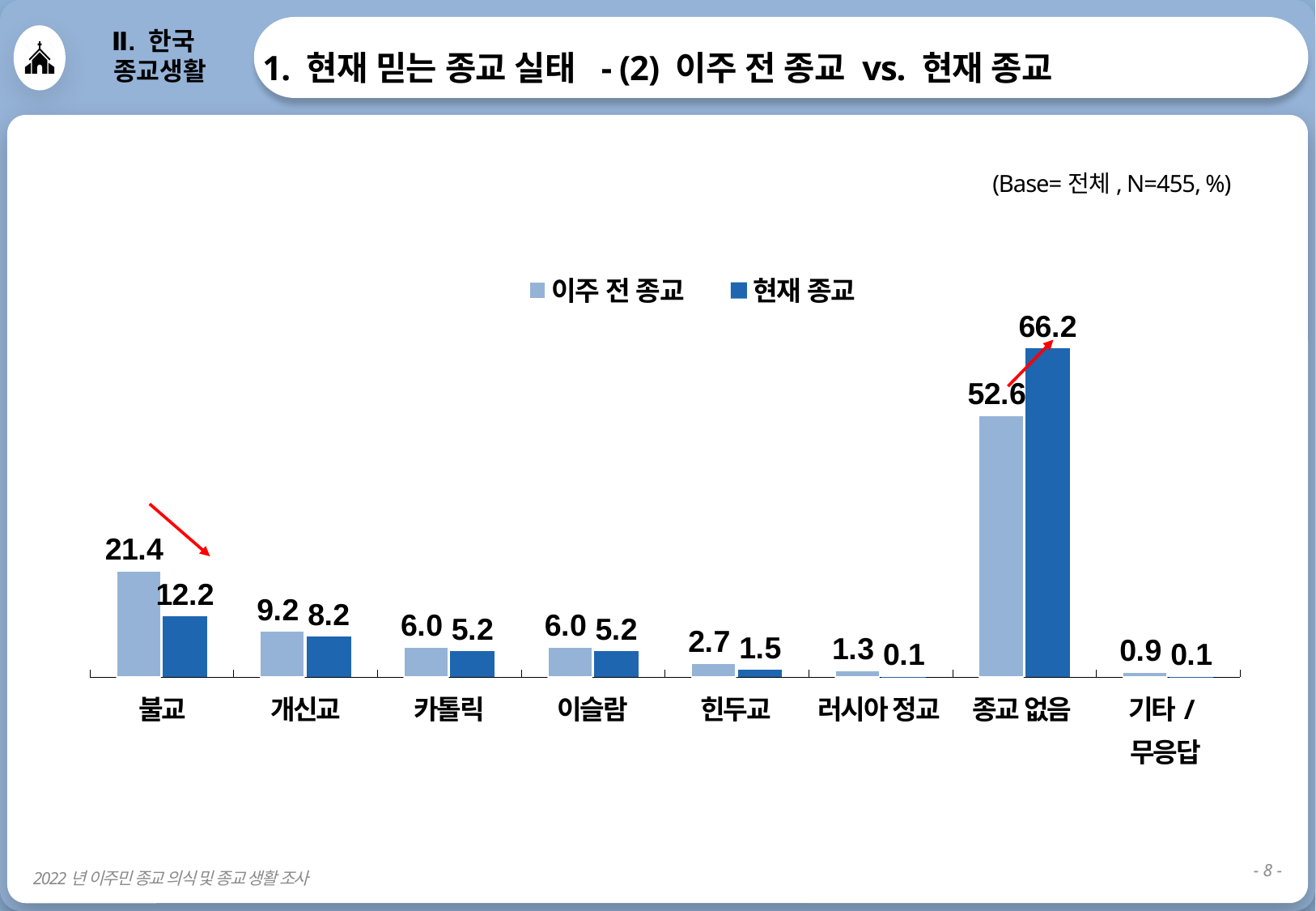
For 개신교, which is larger: the 이주 전 종교 value or the 현재 종교 value? 이주 전 종교 What is the value for 힌두교 in the 현재 종교 series? 1.5 What kind of chart is shown on the slide? bar chart What is the value for 종교 없음 in the 현재 종교 series? 66.2 What are the two series names listed in the legend? 이주 전 종교, 현재 종교 Which category has the highest value in the 이주 전 종교 series? 종교 없음 How many series does the legend list? 2 Which category has the lowest value in the 이주 전 종교 series? 기타 / 무응답 What is the difference between the 이주 전 종교 and 현재 종교 values for 불교? 9.2 What is the difference between the 현재 종교 and 이주 전 종교 values for 종교 없음? 13.6 What is the value for 불교 in the 이주 전 종교 series? 21.4 How many categories are shown on the x axis? 8